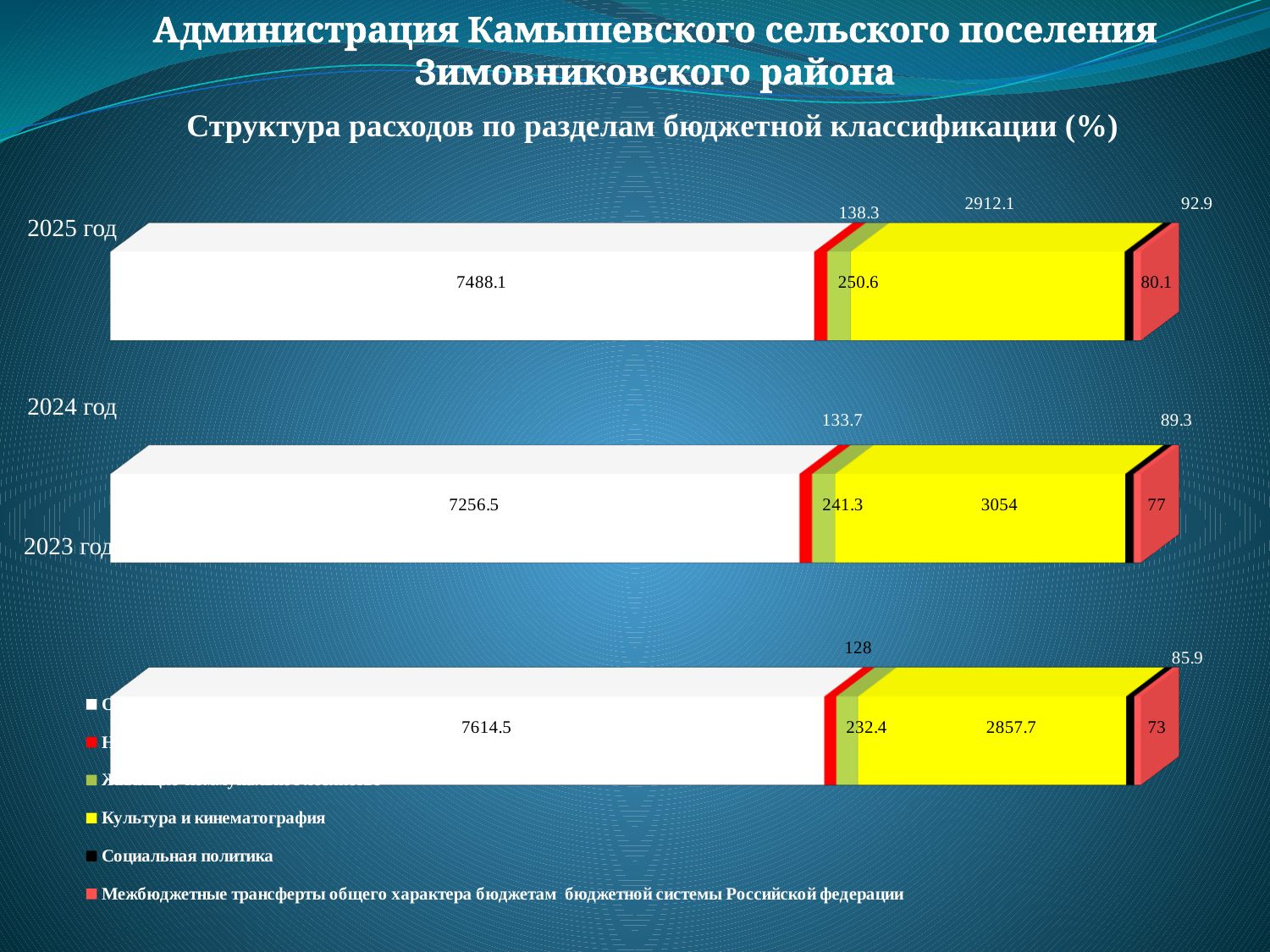
In which year is the value for Культура и кинематография the highest? 2024 год How many bars (years) does the chart show? 3 What is the value of the largest (white) segment in the 2024 год bar? 7256.5 What is the value for Межбюджетные трансферты общего характера бюджетам бюджетной системы Российской федерации in the 2023 год bar? 73 What colour represents Культура и кинематография in the chart? Yellow In which year is the value for Социальная политика the lowest? 2023 год What kind of chart is shown on the slide? Stacked bar chart Which is larger: the Социальная политика value for 2025 год or for 2023 год? 2025 год What is the value for Социальная политика in the 2024 год bar? 89.3 What is the difference between the Культура и кинематография values for 2024 год and 2023 год? 196.3 Does the value for Социальная политика rise or fall from 2023 год to 2025 год? Rises What is the value for Культура и кинематография in the 2025 год bar? 2912.1